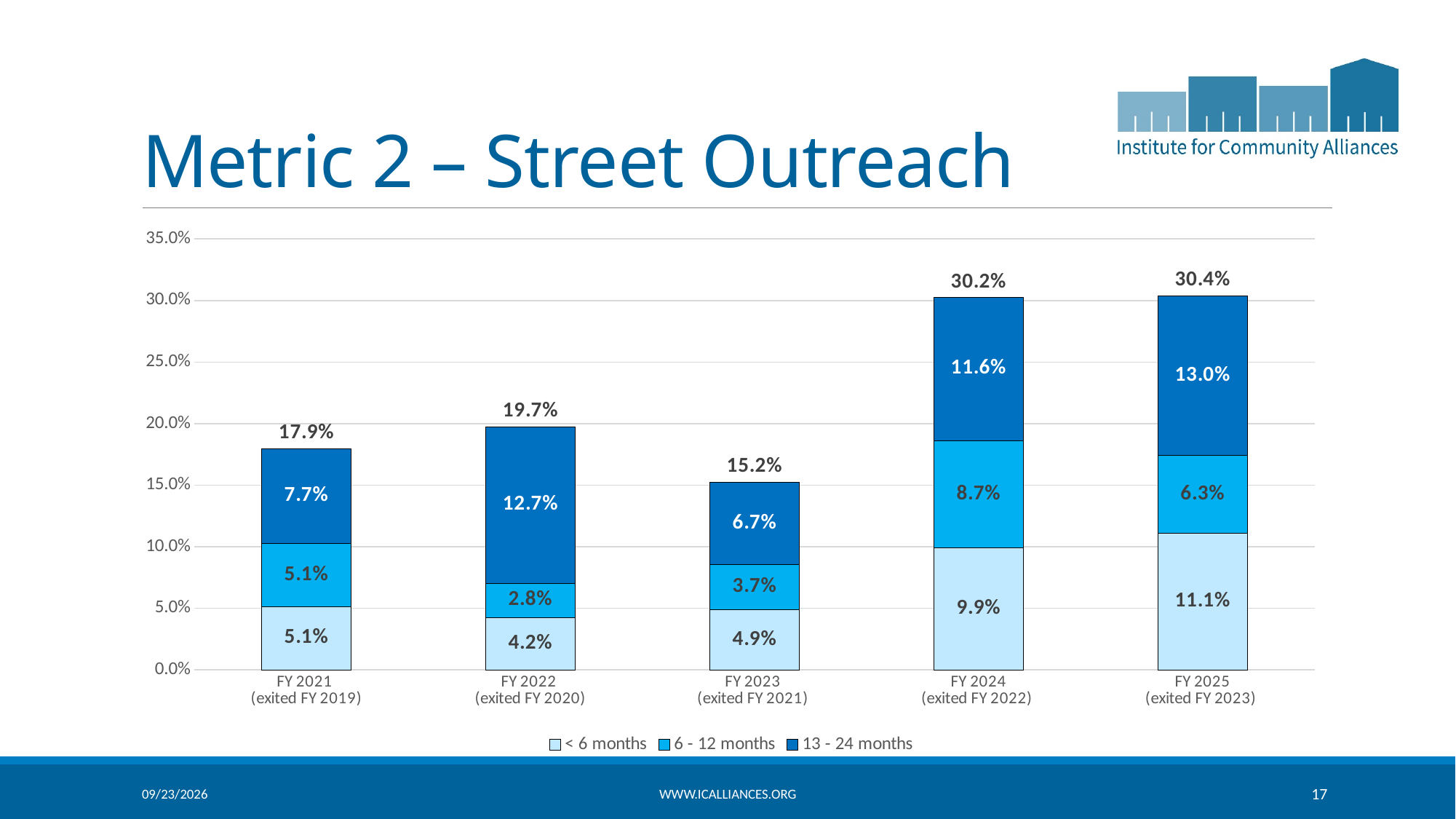
Which fiscal year has the lowest stacked bar total? FY 2023 (exited FY 2021) What kind of chart is shown on the slide? Stacked bar chart What is the total of the stacked bar for FY 2023 (exited FY 2021)? 15.2% How many series does the legend list? 3 Which is larger: the < 6 months value for FY 2024 or for FY 2025? FY 2025 What is the title of the slide containing the chart? Metric 2 – Street Outreach What is the value of the 13 - 24 months segment for FY 2022 (exited FY 2020)? 12.7% What is the value of the < 6 months segment for FY 2025 (exited FY 2023)? 11.1% Which fiscal year has the highest stacked bar total? FY 2025 (exited FY 2023) What is the difference between the 13 - 24 months values for FY 2025 and FY 2024? 1.4% What is the value of the 6 - 12 months segment for FY 2024 (exited FY 2022)? 8.7% How many fiscal year categories are shown on the x axis? 5